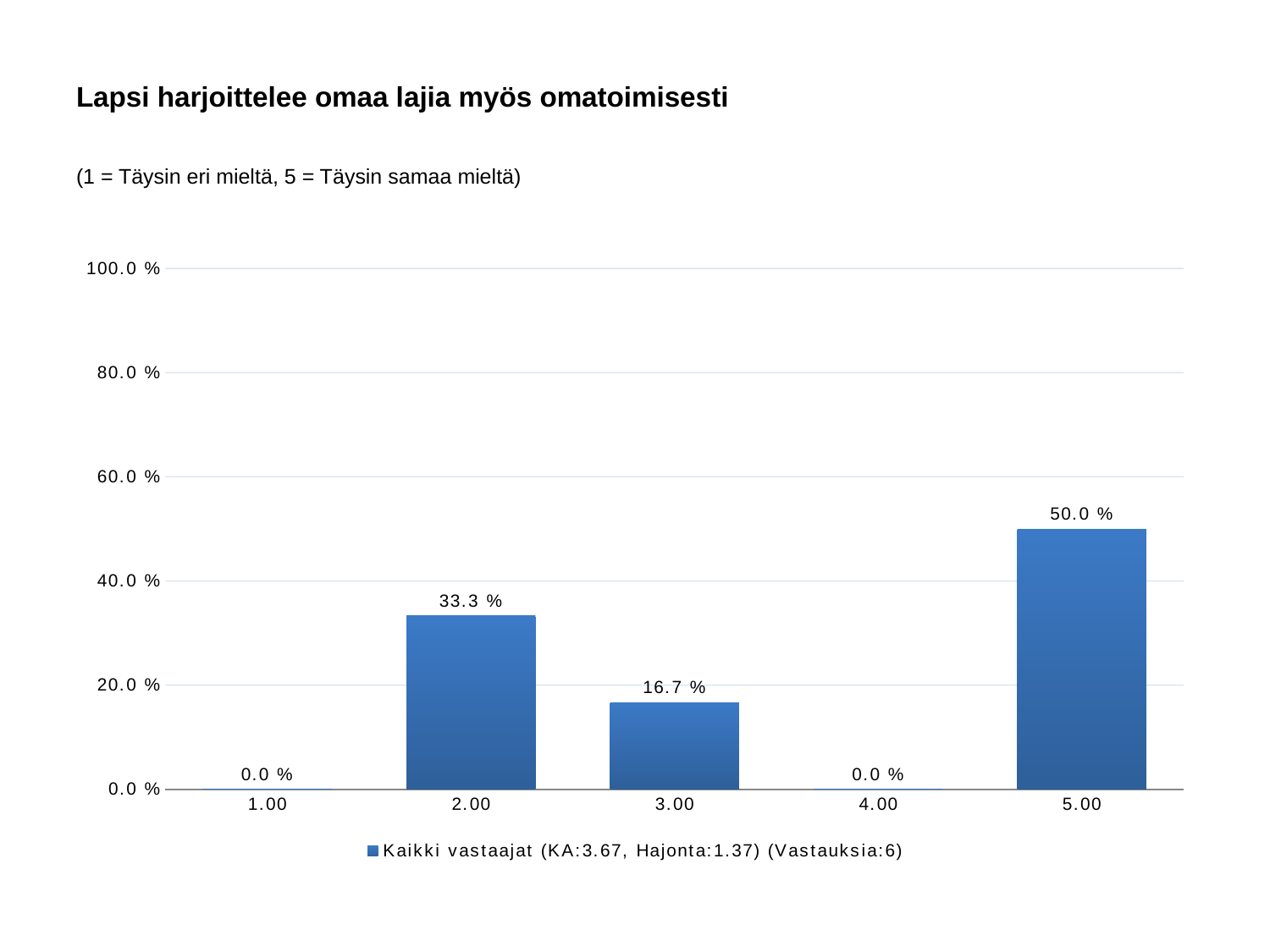
What is the value for category 5.00? 50.0 % Is the value for 5.00 greater or less than 40.0 %? greater What is the value for category 4.00? 0.0 % Which category has the highest value? 5.00 Which is larger, the value for 2.00 or the value for 3.00? 2.00 What is the difference between the values for 5.00 and 2.00? 16.7 % What kind of chart is shown? bar chart What is the value for category 2.00? 33.3 % How many categories are shown on the x axis? 5 What is the title of the chart? Lapsi harjoittelee omaa lajia myös omatoimisesti How many series does the legend list? 1 What is the value for category 3.00? 16.7 %